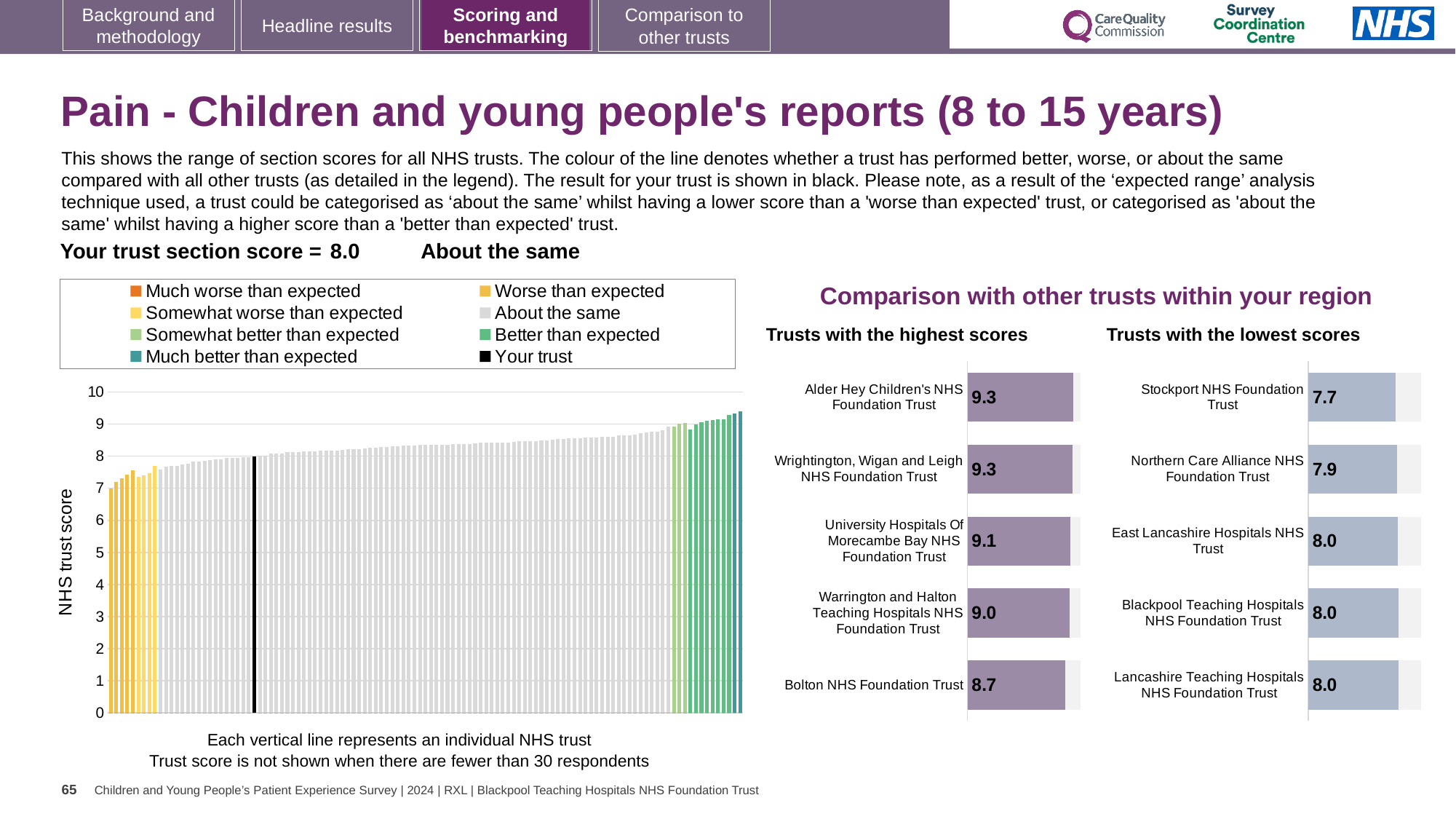
On the 'Trusts with the lowest scores' chart, which trust has the lowest score? Stockport NHS Foundation Trust How many entries does the legend of the NHS trust score chart on the left list? 8 How many trusts are listed on the 'Trusts with the lowest scores' chart? 5 On the 'Trusts with the highest scores' chart, what is the score for Alder Hey Children's NHS Foundation Trust? 9.3 On the 'Trusts with the lowest scores' chart, what is the score for Stockport NHS Foundation Trust? 7.7 On the 'Trusts with the highest scores' chart, what is the difference between the scores of Alder Hey Children's NHS Foundation Trust and Bolton NHS Foundation Trust? 0.6 On the NHS trust score chart on the left, what is the section score for your trust? 8.0 On the 'Trusts with the highest scores' chart, which has the larger score: University Hospitals Of Morecambe Bay NHS Foundation Trust or Bolton NHS Foundation Trust? University Hospitals Of Morecambe Bay NHS Foundation Trust On the 'Trusts with the highest scores' chart, which trust has the lowest score? Bolton NHS Foundation Trust On the 'Trusts with the lowest scores' chart, what is the difference between the scores of Northern Care Alliance NHS Foundation Trust and Stockport NHS Foundation Trust? 0.2 On the NHS trust score chart on the left, do the bar values rise or fall from left to right? rise On the 'Trusts with the highest scores' chart, what is the score for Bolton NHS Foundation Trust? 8.7